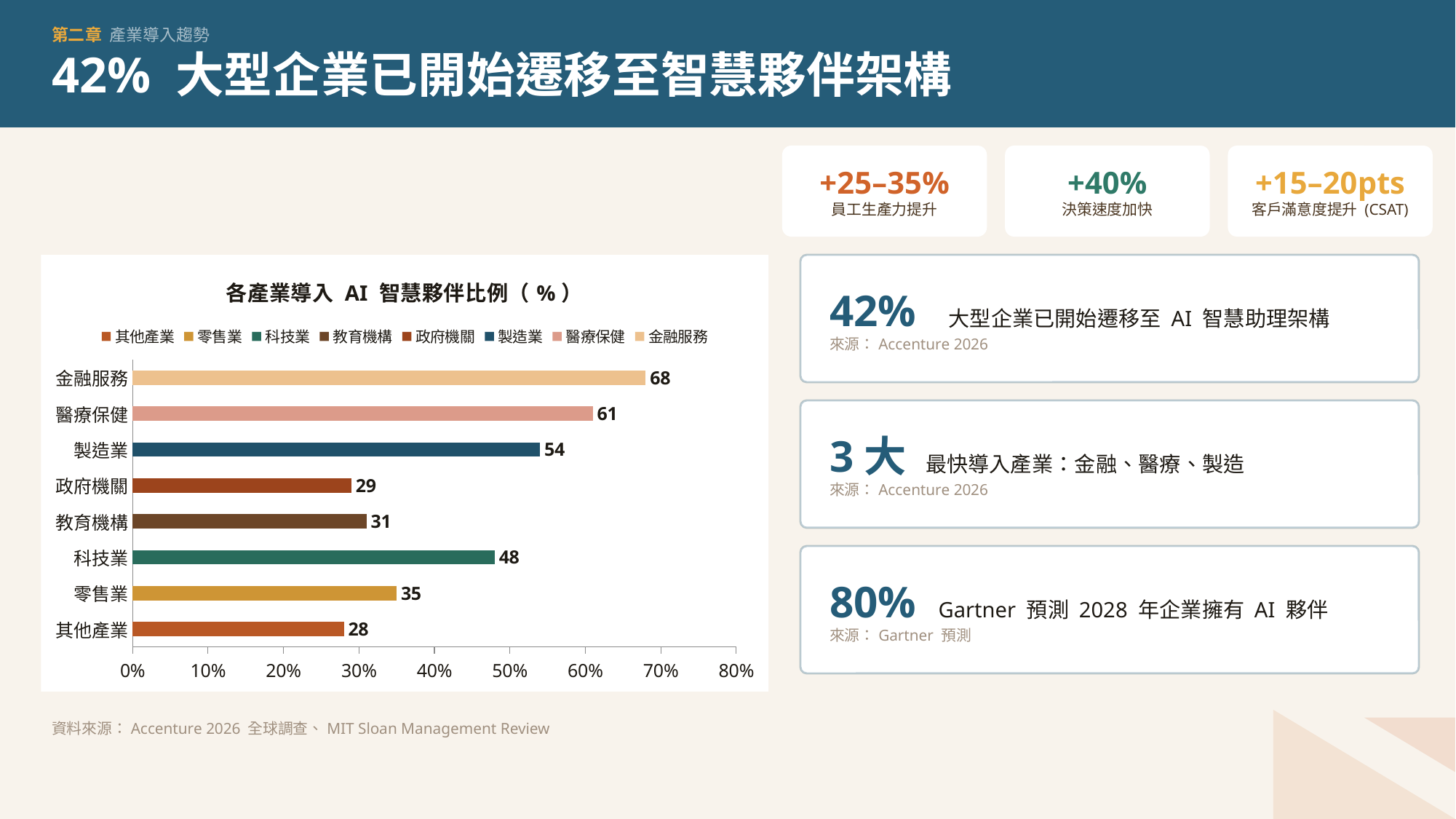
What is the title of the chart? 各產業導入 AI 智慧夥伴比例（%） What kind of chart is shown on the slide? bar chart What is the difference between the values for 金融服務 and 醫療保健? 7 Which category has the highest value in the chart? 金融服務 What is the value for 金融服務 in the chart? 68 How many categories are shown in the chart? 8 Is the value for 醫療保健 greater or less than 50%? greater Which is larger, the value for 教育機構 or the value for 政府機關? 教育機構 What is the value for 政府機關 in the chart? 29 What is the difference between the values for 製造業 and 零售業? 19 What is the value for 科技業 in the chart? 48 Which category has the lowest value in the chart? 其他產業